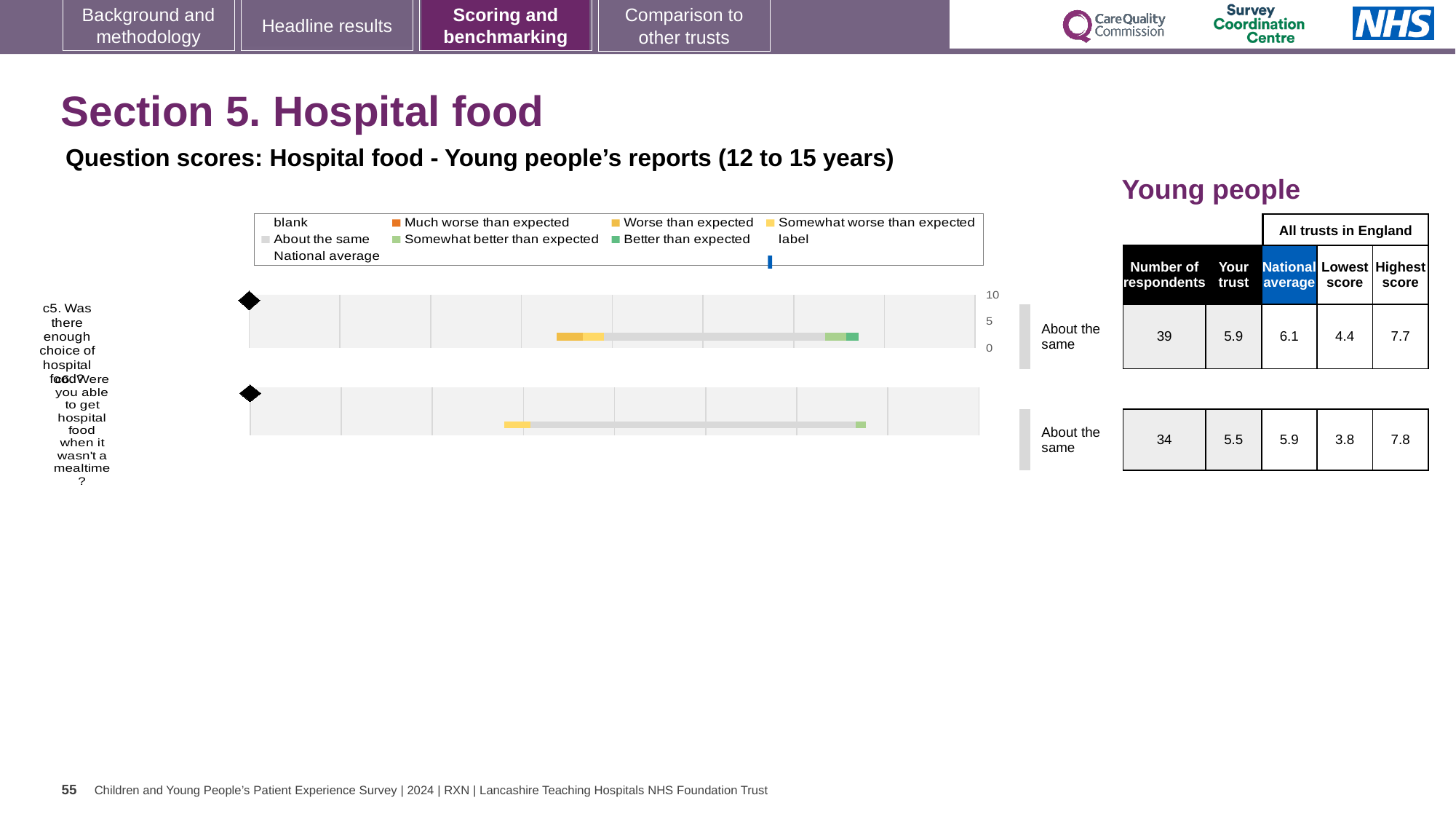
What is the lowest score across all trusts in England for question c6? 3.8 How many questions are plotted in the hospital food chart? 2 How many respondents answered question c5? 39 What is the maximum value shown on the chart's score axis? 10 What is the national average score for question c6 (Were you able to get hospital food when it wasn't a mealtime?)? 5.9 What benchmark category is shown for question c5? About the same What is the difference between the highest and lowest scores for question c5? 3.3 Which question has the higher 'Your trust' score, c5 or c6? c5 How much lower is the trust's score than the national average for question c6? 0.4 What is the 'Your trust' score for question c5 (Was there enough choice of hospital food?)? 5.9 What kind of chart is used to show the question scores for hospital food? Bar chart Which question has the higher highest score across all trusts in England? c6